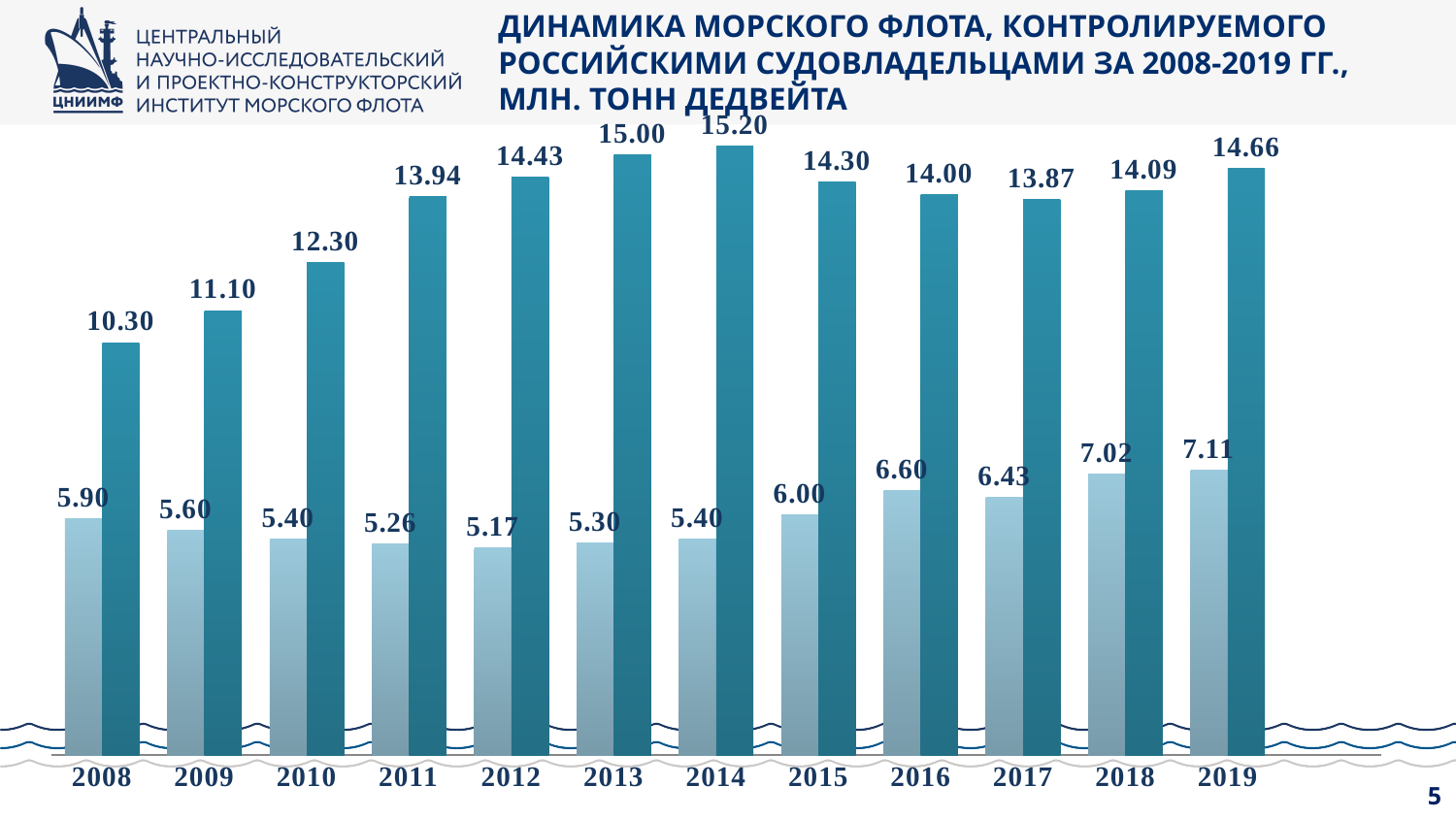
What is the value of the dark teal bar for 2014? 15.20 Which year has the lowest light blue bar? 2012 What unit is stated in the chart title? млн. тонн дедвейта What type of chart is shown on the slide? bar chart Which is larger: the light blue bar for 2016 or the light blue bar for 2017? 2016 Which year has the lowest dark teal bar? 2008 Which year has the highest dark teal bar? 2014 Do the dark teal bars rise or fall from 2008 to 2014? rise How many years are shown on the x axis of the chart? 12 What is the value of the dark teal bar for 2019? 14.66 What is the value of the light blue bar for 2012? 5.17 What is the difference between the dark teal bar values for 2019 and 2008? 4.36